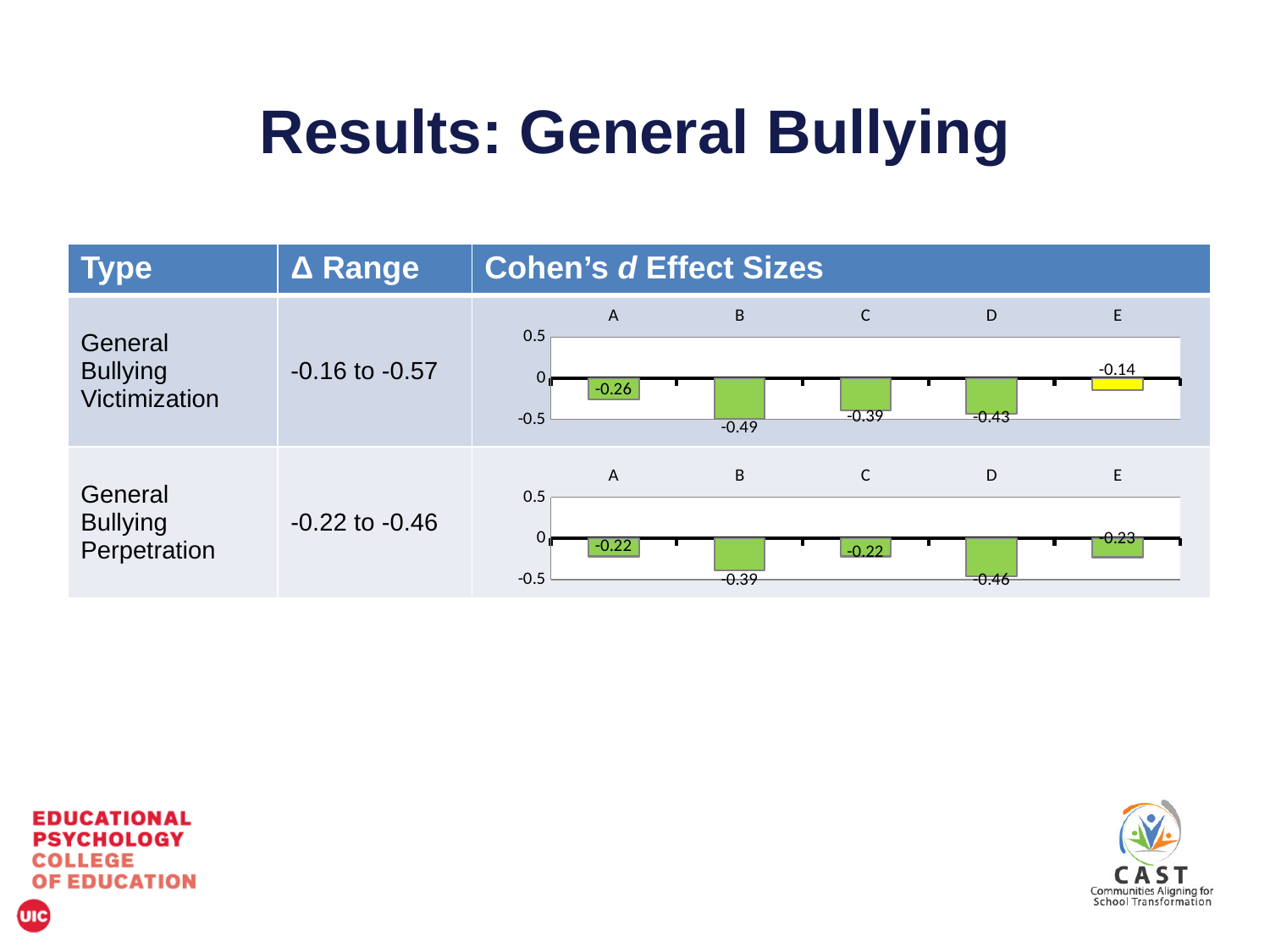
In the General Bullying Perpetration chart, which is more negative, B or D? D In the General Bullying Victimization chart, what is the value for E? -0.14 How many categories are shown in the General Bullying Perpetration chart? 5 In the General Bullying Perpetration chart, what is the value for A? -0.22 In the General Bullying Victimization chart, which category has the lowest (most negative) value? B In the General Bullying Perpetration chart, which category has the lowest (most negative) value? D In the General Bullying Perpetration chart, what is the value for D? -0.46 In the General Bullying Victimization chart, what is the difference between the values for B and E? 0.35 In the General Bullying Victimization chart, what is the value for B? -0.49 What type of chart is used to show the Cohen's d effect sizes? Bar chart In the General Bullying Victimization chart, which category has the highest (least negative) value? E In the General Bullying Victimization chart, which bar is coloured yellow instead of green? E